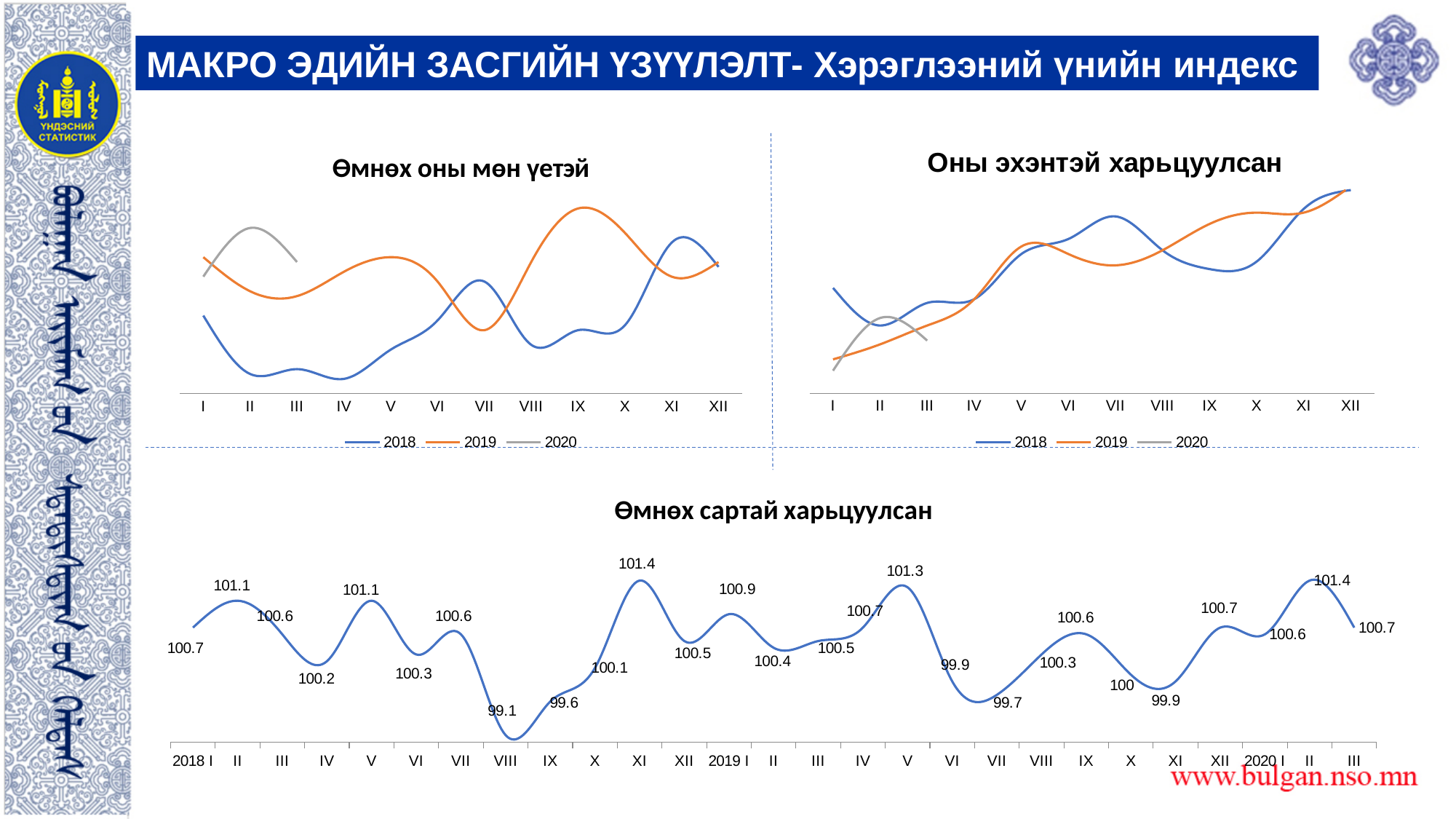
In the chart titled "Өмнөх сартай харьцуулсан", what is the value for 2018 VIII? 99.1 What kind of chart is the chart titled "Өмнөх сартай харьцуулсан"? Line chart In the chart titled "Өмнөх сартай харьцуулсан", which month has the lowest value? 2018 VIII In the chart titled "Өмнөх сартай харьцуулсан", which is larger: the value for 2019 I or the value for 2019 V? 2019 V In the chart titled "Өмнөх сартай харьцуулсан", what is the value for 2020 III? 100.7 In the chart titled "Оны эхэнтэй харьцуулсан", does the 2019 line generally rise or fall from I to XII? Rise In the chart titled "Өмнөх сартай харьцуулсан", what is the highest value plotted? 101.4 How many series does the legend of the chart titled "Өмнөх оны мөн үетэй" list? 3 In the chart titled "Өмнөх сартай харьцуулсан", how many data points are plotted? 27 What are the legend entries of the chart titled "Оны эхэнтэй харьцуулсан"? 2018, 2019, 2020 In the chart titled "Өмнөх сартай харьцуулсан", what is the value for 2019 V? 101.3 In the chart titled "Өмнөх сартай харьцуулсан", what is the difference between the values for 2018 XI and 2018 VIII? 2.3